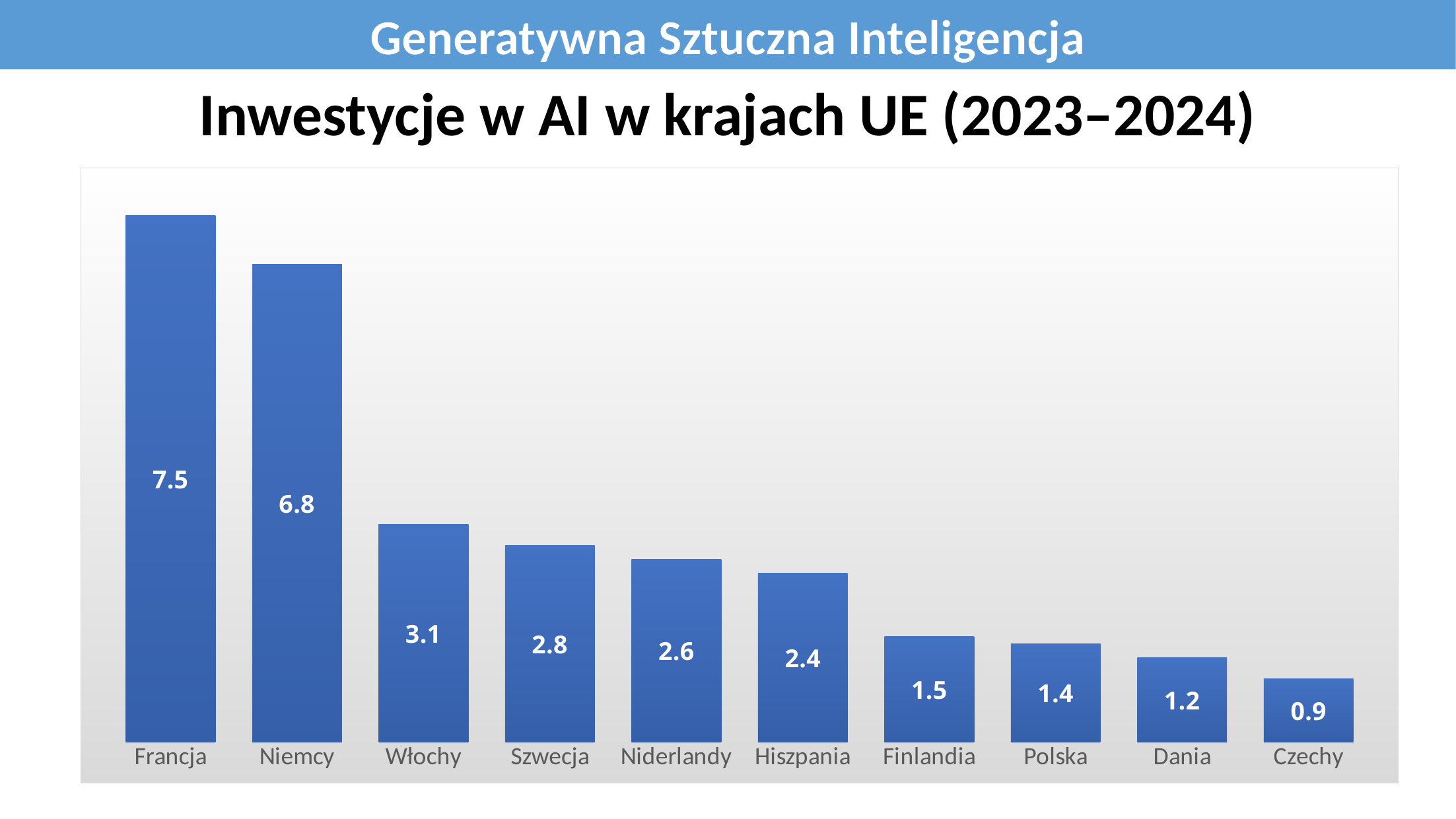
What is the value for Francja? 7.5 What is the title of the chart? Inwestycje w AI w krajach UE (2023–2024) Which country has the highest value? Francja What is the value for Niderlandy? 2.6 What is the difference between the values for Włochy and Hiszpania? 0.7 Which country has the lowest value? Czechy What is the value for Polska? 1.4 What is the difference between the values for Francja and Niemcy? 0.7 What kind of chart is shown on the slide? Bar chart Which is larger, the value for Szwecja or the value for Finlandia? Szwecja How many countries are shown in the chart? 10 Do the values rise or fall from left to right along the x axis? Fall